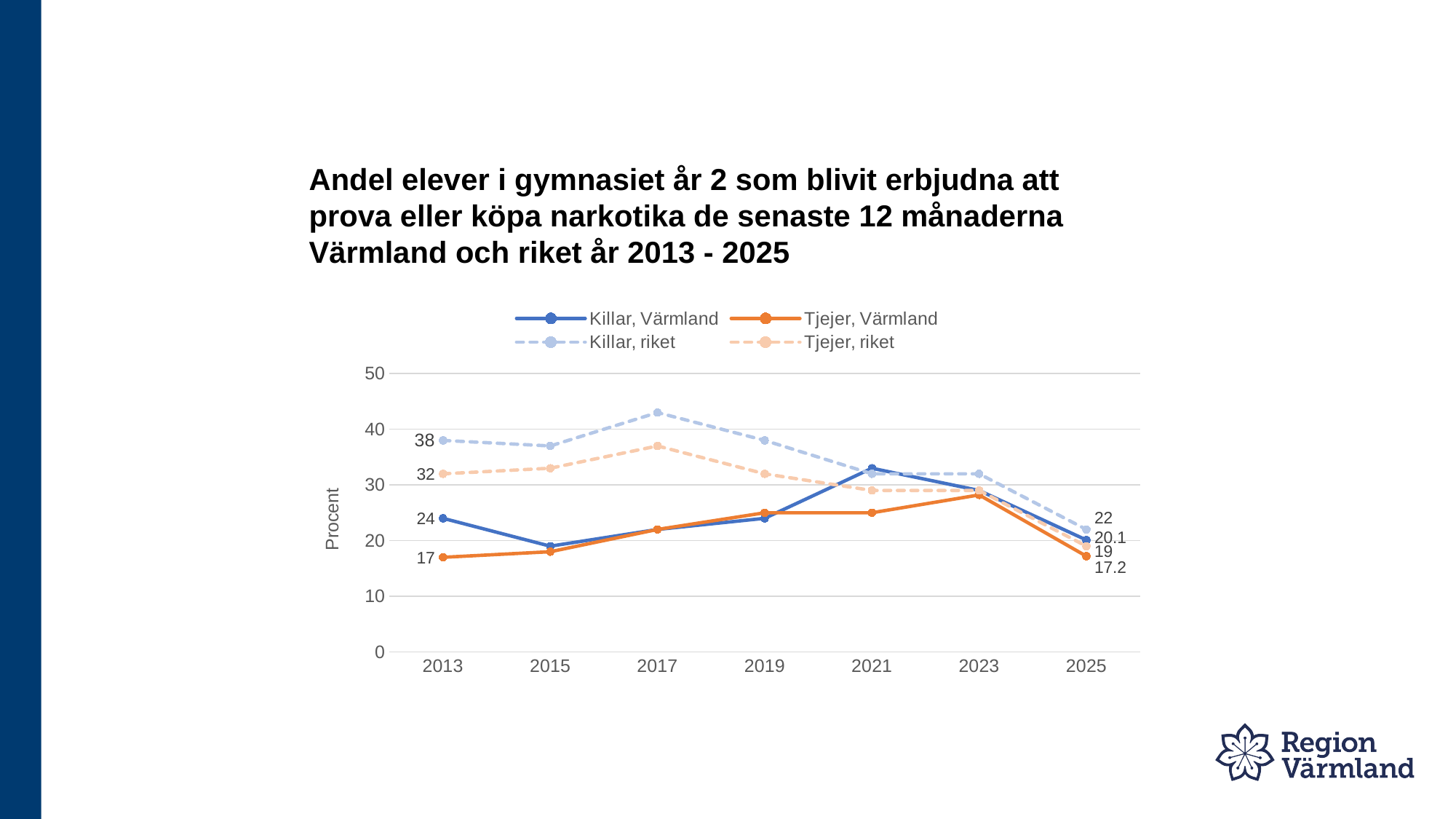
What is the label on the y axis? Procent Is the value for Killar, riket in 2017 greater or less than 40? greater What is the difference between Killar, riket and Tjejer, riket in 2013? 6 Which series has the lowest value in 2025? Tjejer, Värmland What kind of chart is shown on the slide? line chart How many series does the legend list? 4 Which series has the highest value in 2013? Killar, riket What is the value for Killar, riket in 2013? 38 What is the value for Tjejer, Värmland in 2025? 17.2 What is the value for Tjejer, Värmland in 2013? 17 How many years are shown on the x axis? 7 What is the value for Killar, Värmland in 2025? 20.1